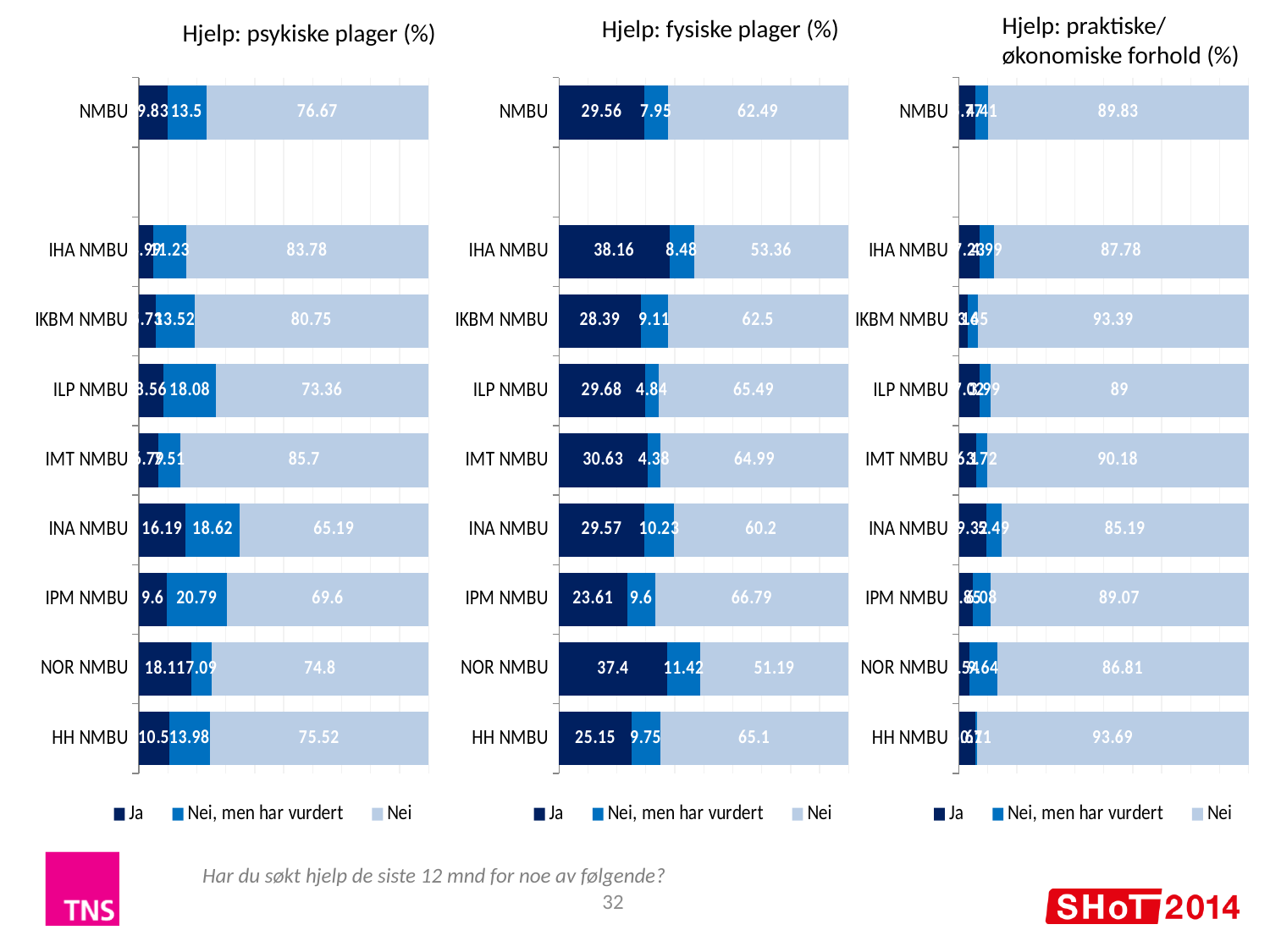
How many categories are shown in the 'Hjelp: fysiske plager (%)' chart? 9 What are the three legend entries in the 'Hjelp: fysiske plager (%)' chart? Ja; Nei, men har vurdert; Nei In the 'Hjelp: psykiske plager (%)' chart, what is the 'Nei, men har vurdert' value for IPM NMBU? 20.79 How many series does the legend of the 'Hjelp: psykiske plager (%)' chart list? 3 In the 'Hjelp: fysiske plager (%)' chart, which category has the highest 'Ja' value? IHA NMBU In the 'Hjelp: psykiske plager (%)' chart, what is the 'Nei' value for NMBU? 76.67 What kind of chart is the 'Hjelp: praktiske/økonomiske forhold (%)' chart? Stacked bar chart In the 'Hjelp: psykiske plager (%)' chart, which is larger: the 'Nei' value for IMT NMBU or for INA NMBU? IMT NMBU In the 'Hjelp: praktiske/økonomiske forhold (%)' chart, which category has the lowest 'Nei' value? INA NMBU In the 'Hjelp: fysiske plager (%)' chart, what is the difference between the 'Ja' values for NOR NMBU and HH NMBU? 12.25 In the 'Hjelp: praktiske/økonomiske forhold (%)' chart, what is the 'Nei' value for HH NMBU? 93.69 In the 'Hjelp: fysiske plager (%)' chart, what is the 'Ja' value for IHA NMBU? 38.16